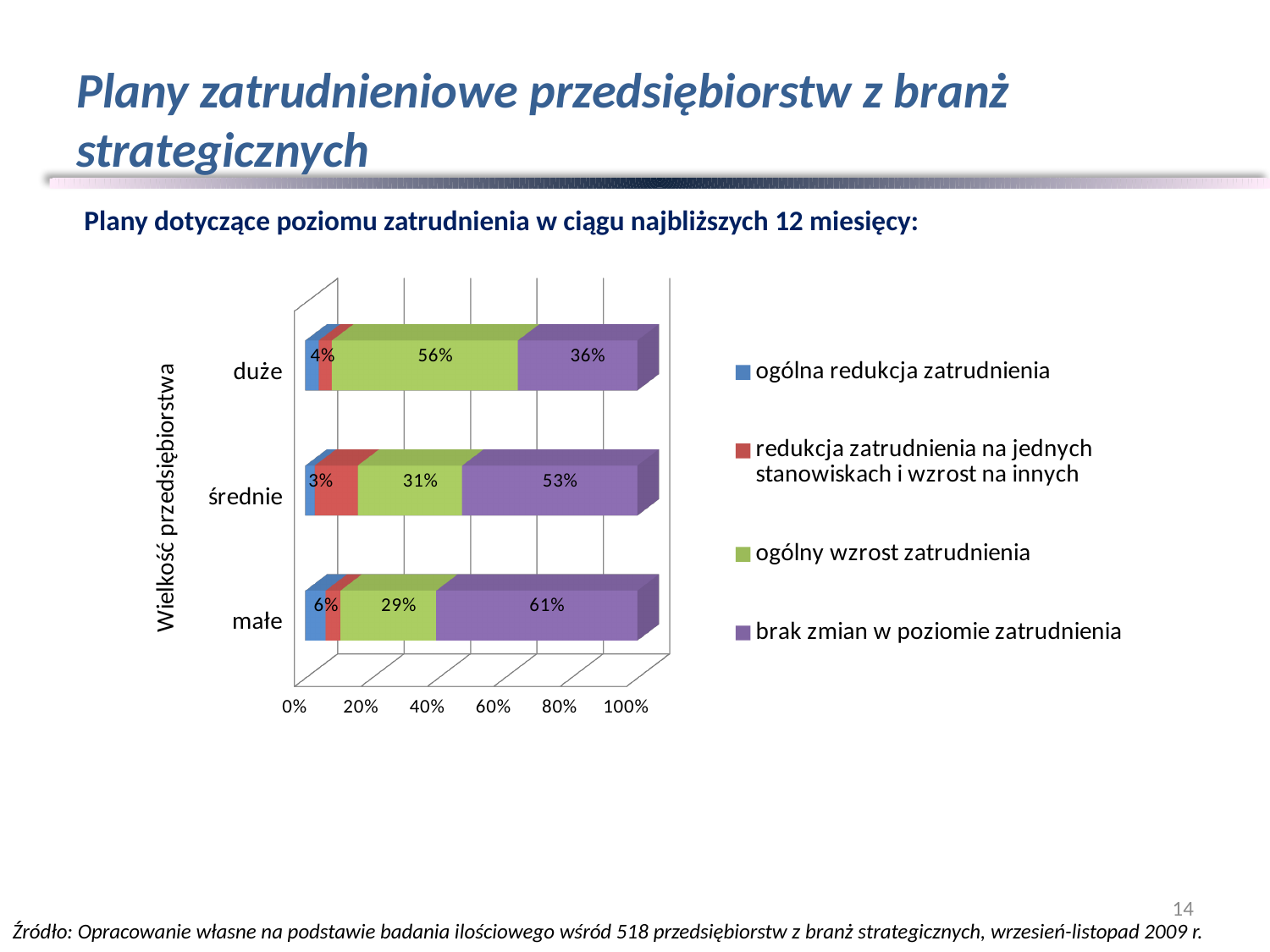
Which company size has the lowest value for 'ogólny wzrost zatrudnienia'? małe What kind of chart is shown on the slide? stacked bar chart How many company-size categories are shown on the chart? 3 What is the difference between the 'brak zmian w poziomie zatrudnienia' values for 'małe' and 'duże' companies? 25% What is the value of 'brak zmian w poziomie zatrudnienia' for 'średnie' companies? 53% How many series does the legend list? 4 Which company size has the highest value for 'brak zmian w poziomie zatrudnienia'? małe What is the value of 'brak zmian w poziomie zatrudnienia' for 'małe' companies? 61% What is the label of the vertical axis of the chart? Wielkość przedsiębiorstwa Which is larger: 'ogólny wzrost zatrudnienia' for 'duże' companies or for 'średnie' companies? duże What is the value of 'ogólny wzrost zatrudnienia' for 'duże' companies? 56% What is the value of 'ogólna redukcja zatrudnienia' for 'średnie' companies? 3%